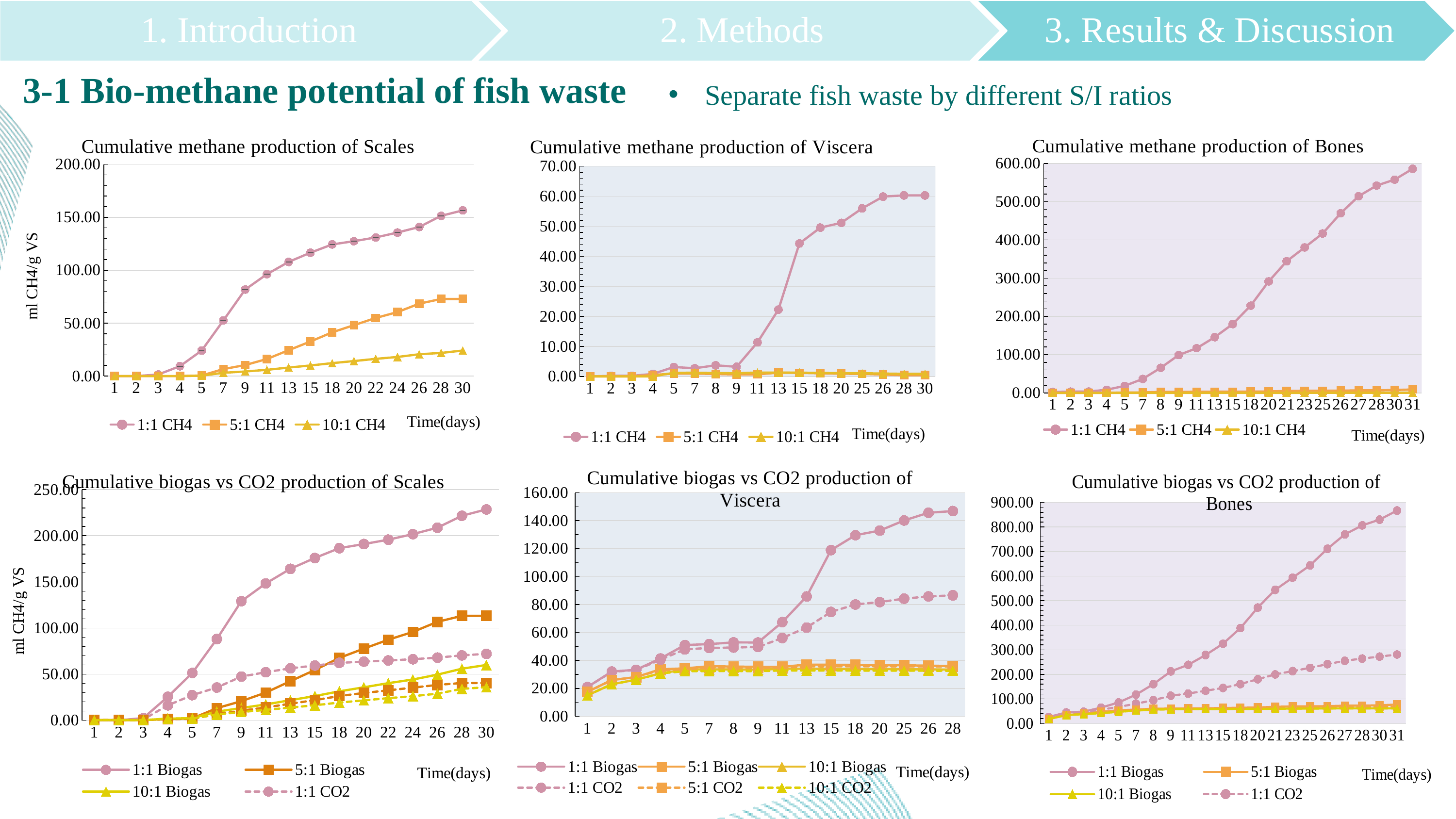
In "Cumulative biogas vs CO2 production of Bones", is the value for 1:1 Biogas at day 31 greater or less than 800? greater How many time points are shown on the x axis of "Cumulative methane production of Scales"? 17 What is the y-axis label of "Cumulative methane production of Scales"? ml CH4/g VS In "Cumulative biogas vs CO2 production of Scales", does the 1:1 Biogas series rise or fall over time? rise What kind of chart is "Cumulative methane production of Scales"? line chart How many series does the legend of "Cumulative biogas vs CO2 production of Viscera" list? 6 In "Cumulative methane production of Scales", which is larger at day 30: 5:1 CH4 or 10:1 CH4? 5:1 CH4 How many time points are shown on the x axis of "Cumulative methane production of Bones"? 21 In "Cumulative methane production of Viscera", is the value for 1:1 CH4 at day 30 greater or less than 50? greater In "Cumulative methane production of Bones", which series has the highest value at day 31? 1:1 CH4 How many series does the legend of "Cumulative methane production of Bones" list? 3 In "Cumulative methane production of Scales", is the value for 1:1 CH4 at day 30 greater or less than 150? greater